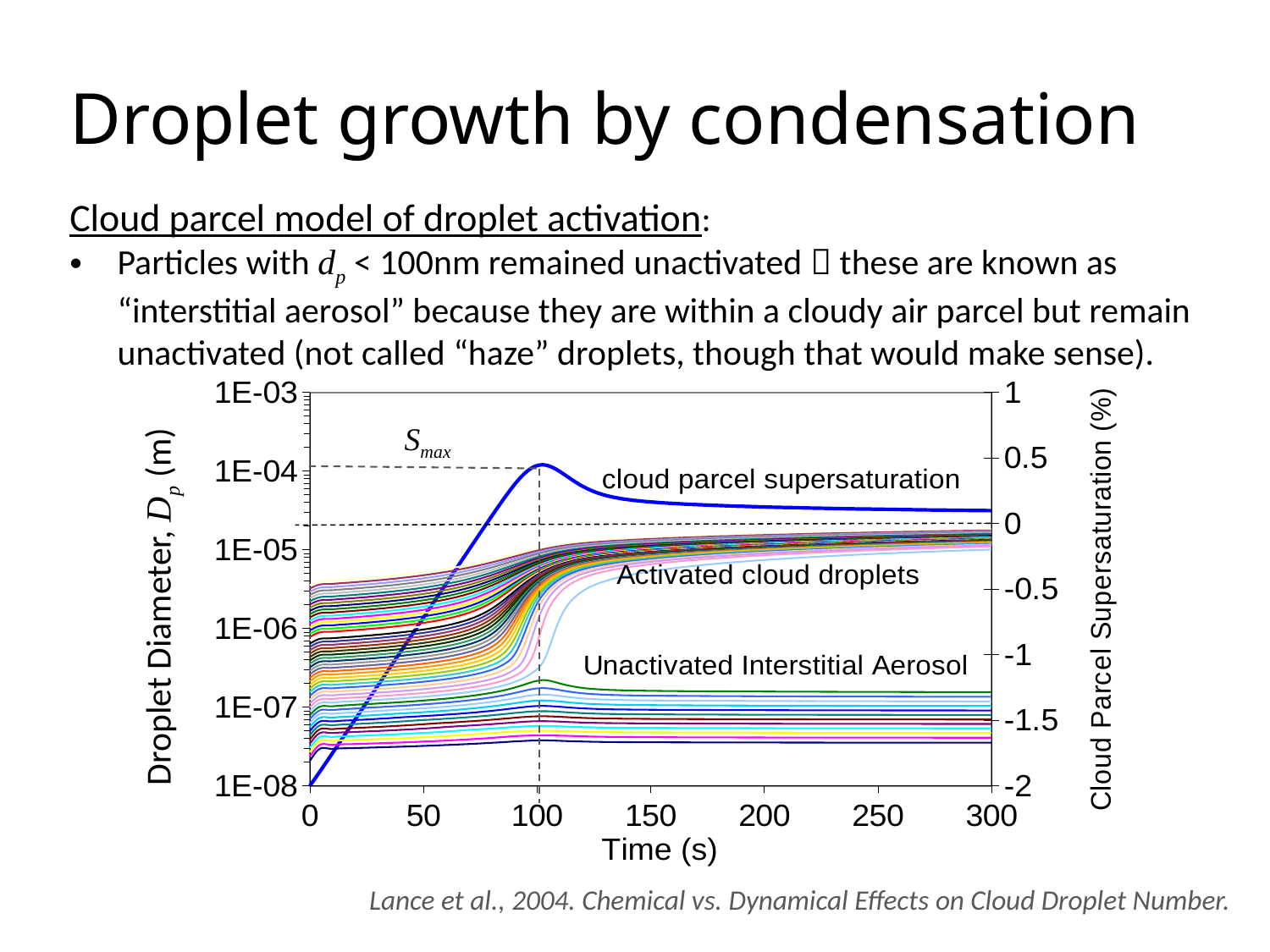
Is the cloud parcel supersaturation at 100 s greater or less than 0? greater What kind of chart is shown on the slide? line chart Does the cloud parcel supersaturation rise or fall between 100 s and 300 s? fall What is the label of the right-hand y axis? Cloud Parcel Supersaturation (%) Is the cloud parcel supersaturation at 300 s greater or less than 0.5? less Is the droplet diameter of the unactivated interstitial aerosol at 300 s greater or less than 1E-06 m? less At 300 s, which group has the larger droplet diameter: the activated cloud droplets or the unactivated interstitial aerosol? Activated cloud droplets What is the label of the x axis? Time (s) Does the droplet diameter of the activated cloud droplets rise or fall between 0 s and 300 s? rise